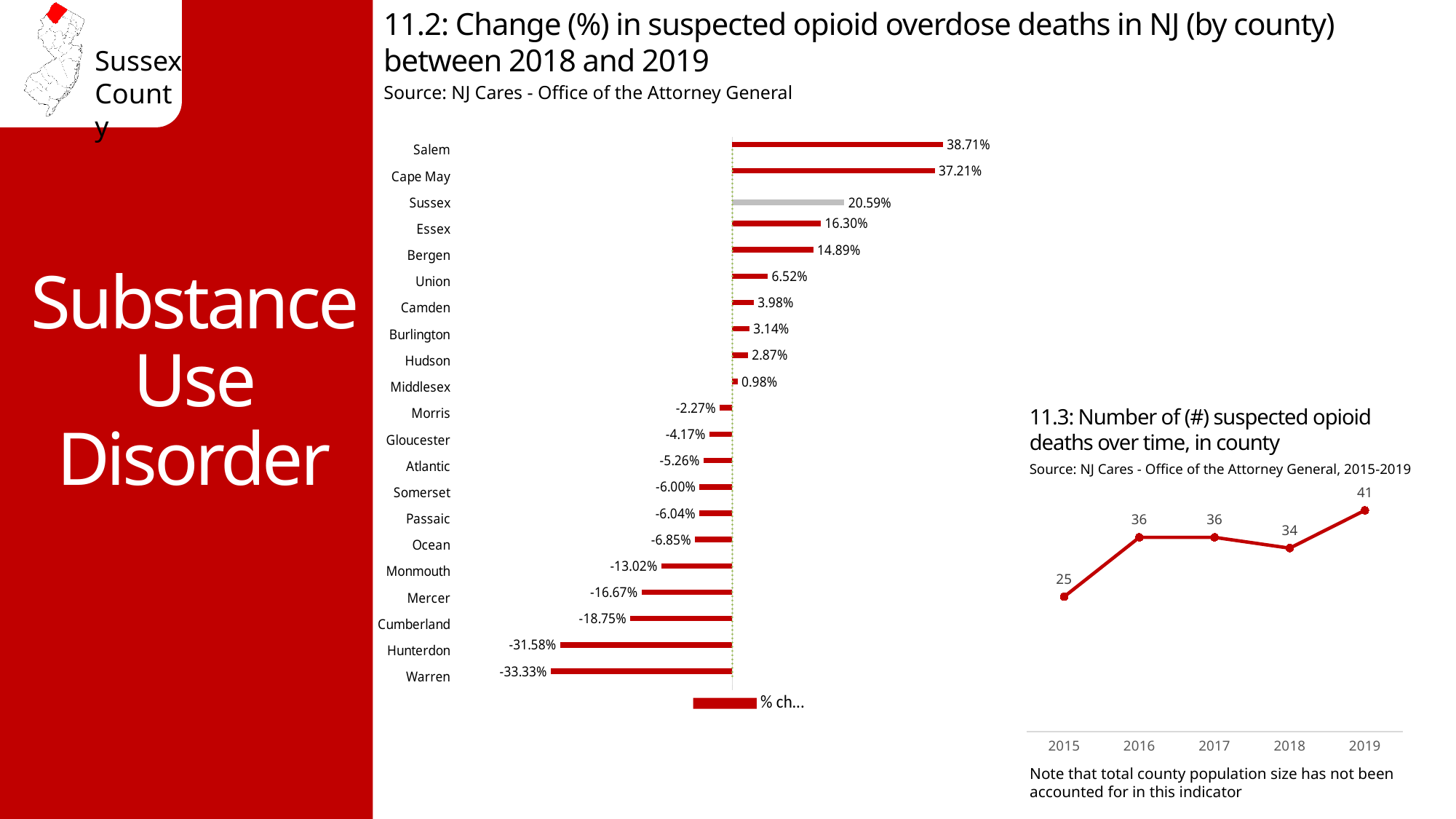
What kind of chart is '11.3: Number of (#) suspected opioid deaths over time, in county'? Line chart In the chart '11.2: Change (%) in suspected opioid overdose deaths in NJ (by county) between 2018 and 2019', which county has the lowest value? Warren In the chart '11.2: Change (%) in suspected opioid overdose deaths in NJ (by county) between 2018 and 2019', what is the value for Hunterdon? -31.58% In the chart '11.2: Change (%) in suspected opioid overdose deaths in NJ (by county) between 2018 and 2019', what is the value for Sussex? 20.59% In the chart '11.3: Number of (#) suspected opioid deaths over time, in county', which year has the lowest value? 2015 In the chart '11.2: Change (%) in suspected opioid overdose deaths in NJ (by county) between 2018 and 2019', what is the difference between the values for Salem and Cape May? 1.50% In the chart '11.2: Change (%) in suspected opioid overdose deaths in NJ (by county) between 2018 and 2019', which county has the highest value? Salem In the chart '11.2: Change (%) in suspected opioid overdose deaths in NJ (by county) between 2018 and 2019', which is larger, the value for Essex or the value for Bergen? Essex What kind of chart is '11.2: Change (%) in suspected opioid overdose deaths in NJ (by county) between 2018 and 2019'? Bar chart In the chart '11.3: Number of (#) suspected opioid deaths over time, in county', what is the value for 2019? 41 In the chart '11.2: Change (%) in suspected opioid overdose deaths in NJ (by county) between 2018 and 2019', how many counties are shown? 21 In the chart '11.3: Number of (#) suspected opioid deaths over time, in county', what is the difference between the values for 2019 and 2015? 16